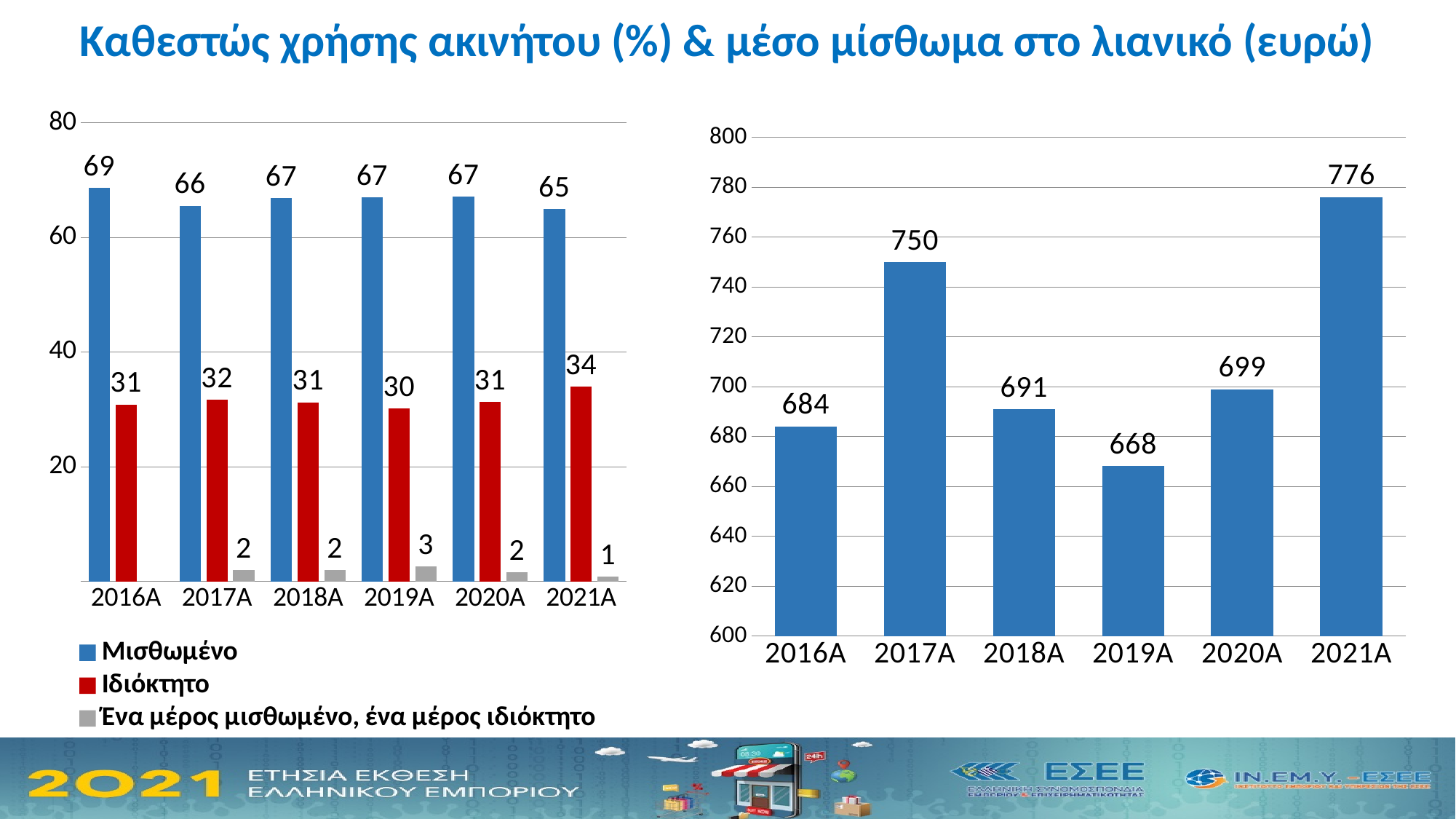
In the right chart, how many years are shown on the x axis? 6 In the right chart, which year has the lowest value? 2019A In the right chart, which year has the highest value? 2021A How many series does the legend of the left chart list? 3 In the right chart, what is the value for 2021A? 776 In the right chart, what is the difference between the values for 2021A and 2016A? 92 In the left chart, what is the value of Ιδιόκτητο for 2021A? 34 What kind of chart is the right chart? bar chart In the left chart, in which year is the Ιδιόκτητο value highest? 2021A In the left chart, what is the difference between Μισθωμένο and Ιδιόκτητο for 2019A? 37 In the right chart, is the value for 2017A larger or smaller than the value for 2018A? larger In the left chart, what is the value of Μισθωμένο for 2016A? 69